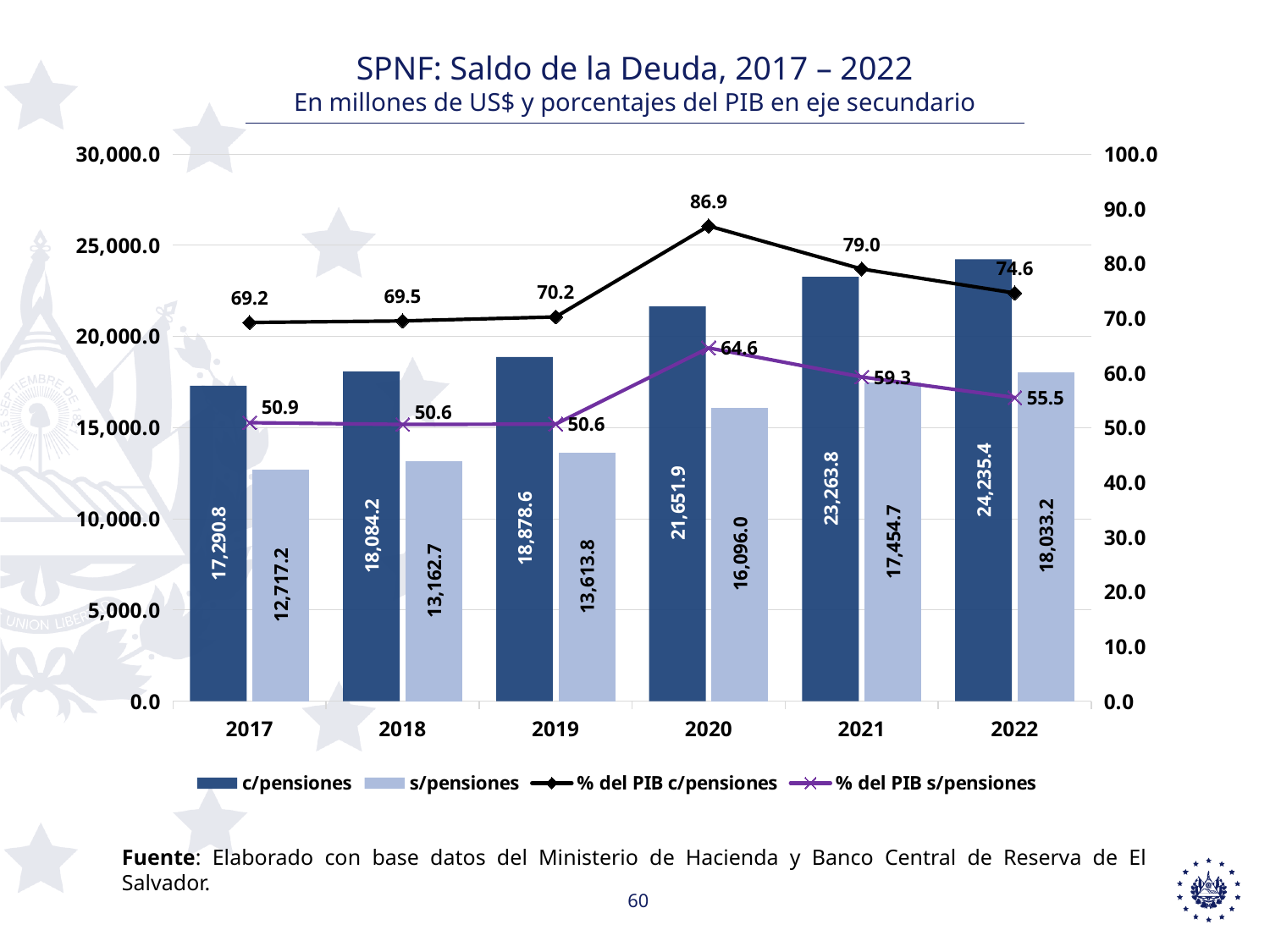
What is the value of s/pensiones for 2022? 18,033.2 Which year has the larger % del PIB s/pensiones value, 2020 or 2021? 2020 In which year is s/pensiones lowest? 2017 In which year is % del PIB c/pensiones highest? 2020 What is the difference between c/pensiones in 2022 and in 2021? 971.6 Does the c/pensiones series rise or fall from 2017 to 2022? rise What is the value of c/pensiones for 2020? 21,651.9 What is the % del PIB s/pensiones value for 2017? 50.9 What is the % del PIB c/pensiones value for 2021? 79.0 How many years are shown on the x axis? 6 By how much did % del PIB c/pensiones increase from 2019 to 2020? 16.7 How many series does the legend list? 4